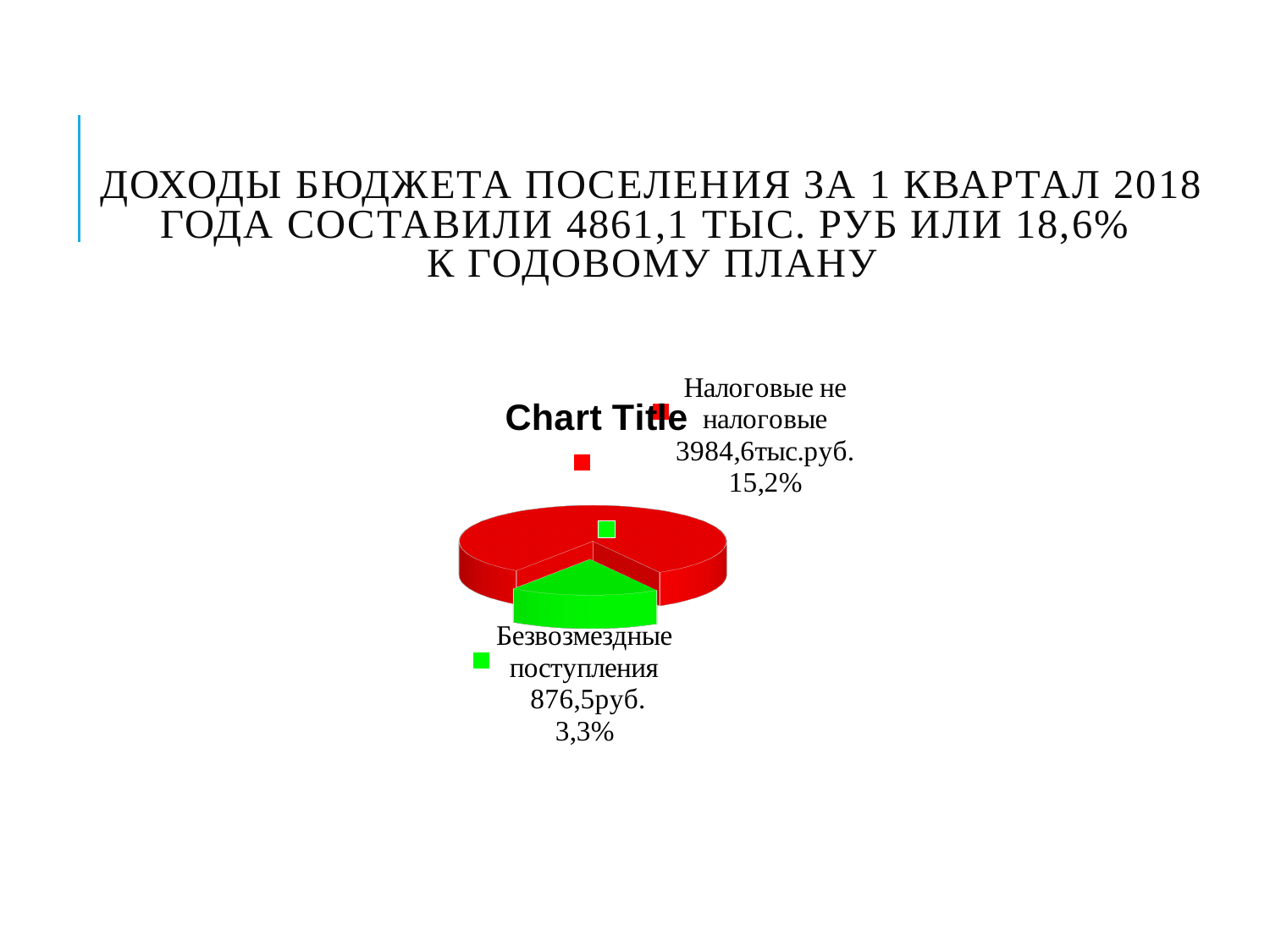
What colour is the 'Безвозмездные поступления' slice? green What is the title shown above the pie chart? Chart Title What is the difference between the 'Налоговые не налоговые' value (3984,6) and the 'Безвозмездные поступления' value (876,5)? 3108,1 Which is larger: 'Налоговые не налоговые' or 'Безвозмездные поступления'? Налоговые не налоговые What value is labelled for the 'Налоговые не налоговые' slice? 3984,6тыс.руб. Which slice of the pie chart is the largest? Налоговые не налоговые What percentage is shown for the 'Налоговые не налоговые' slice? 15,2% What kind of chart is shown on the slide? pie chart How many slices does the pie chart have? 2 What percentage is shown for the 'Безвозмездные поступления' slice? 3,3% Which slice of the pie chart is the smallest? Безвозмездные поступления What value is labelled for the 'Безвозмездные поступления' slice? 876,5руб.